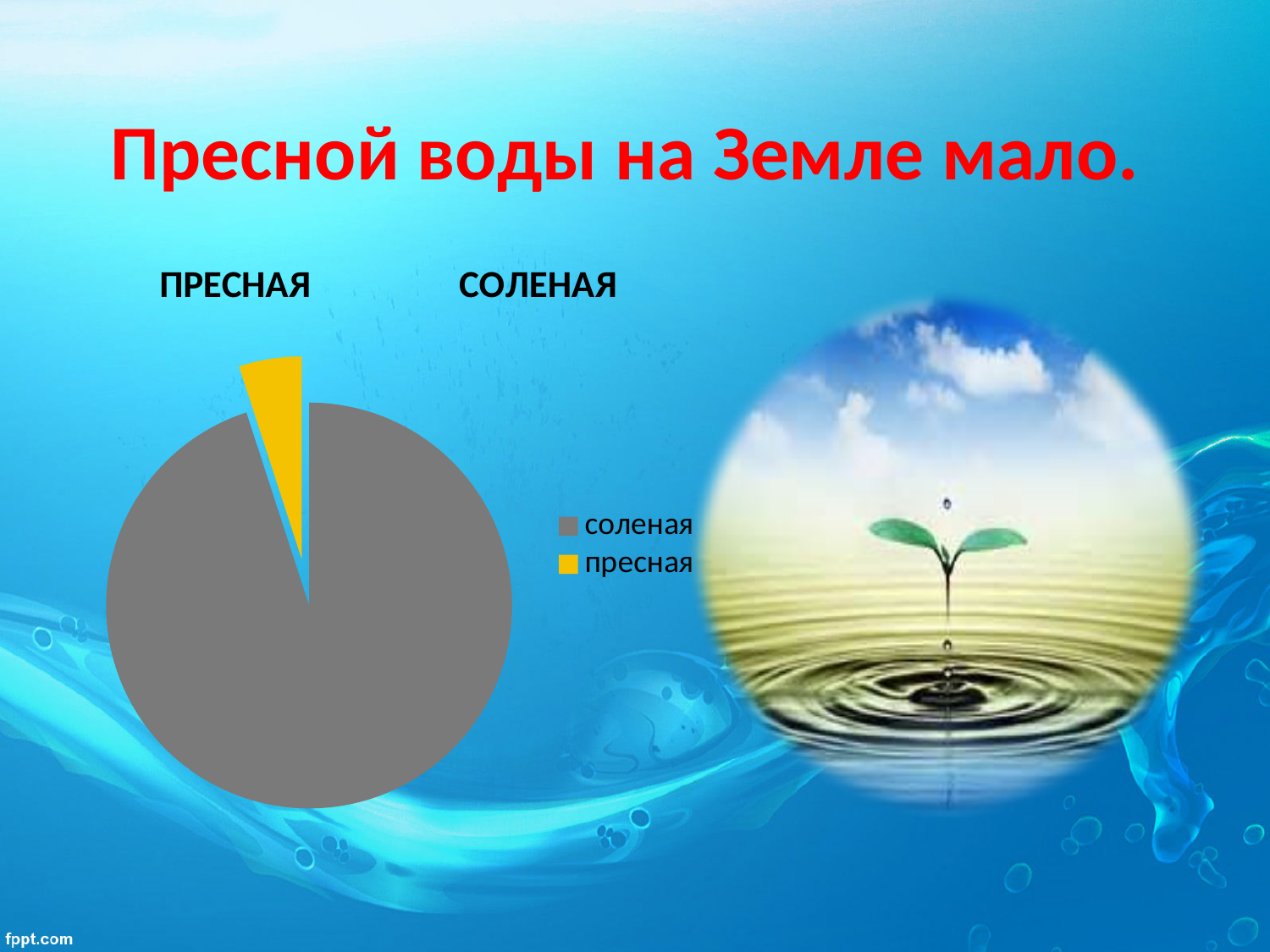
How many slices does the pie chart have? 2 Which category has the smallest slice in the pie chart? пресная Which category has the largest slice in the pie chart? соленая What kind of chart is shown on the slide? pie chart How many entries does the legend of the pie chart list? 2 What colour is the пресная slice in the pie chart? yellow What colour is the соленая slice in the pie chart? grey Which slice is larger in the pie chart, соленая or пресная? соленая